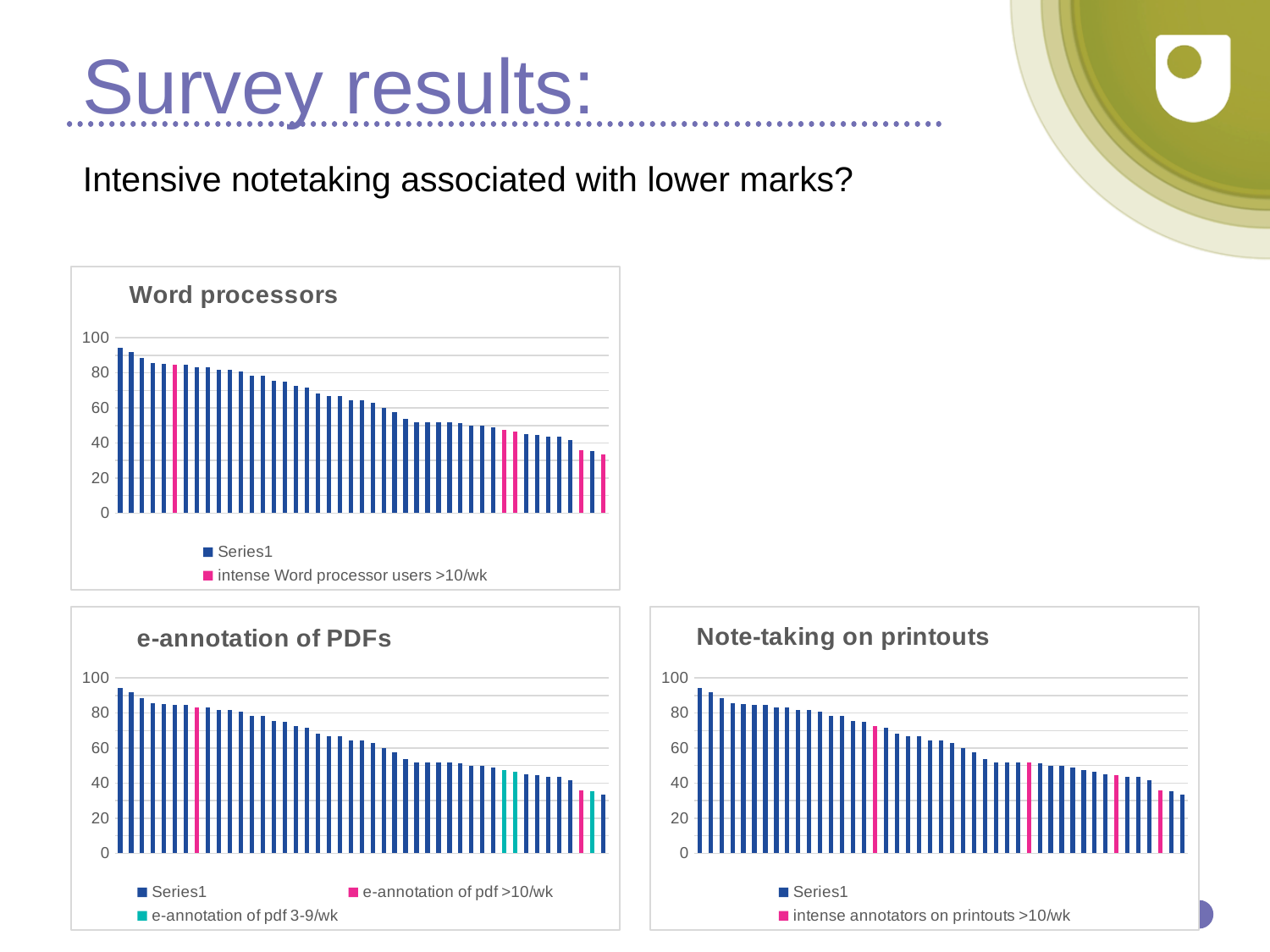
In the "Note-taking on printouts" chart, do the bar values rise or fall from left to right? fall How many series does the legend of the "Note-taking on printouts" chart list? 2 In the "Word processors" chart, do the bar values rise or fall from left to right? fall How many series does the legend of the "Word processors" chart list? 2 What kind of chart is the "Word processors" chart? bar chart In the "Note-taking on printouts" chart, is the value of the rightmost bar greater or less than 40? less In the "e-annotation of PDFs" chart, which series is shown in teal/green? e-annotation of pdf 3-9/wk In the "Word processors" chart, is the value of the leftmost bar greater or less than 80? greater What is the second legend entry of the "Note-taking on printouts" chart? intense annotators on printouts >10/wk In the "e-annotation of PDFs" chart, is the value of the leftmost bar greater or less than 80? greater How many series does the legend of the "e-annotation of PDFs" chart list? 3